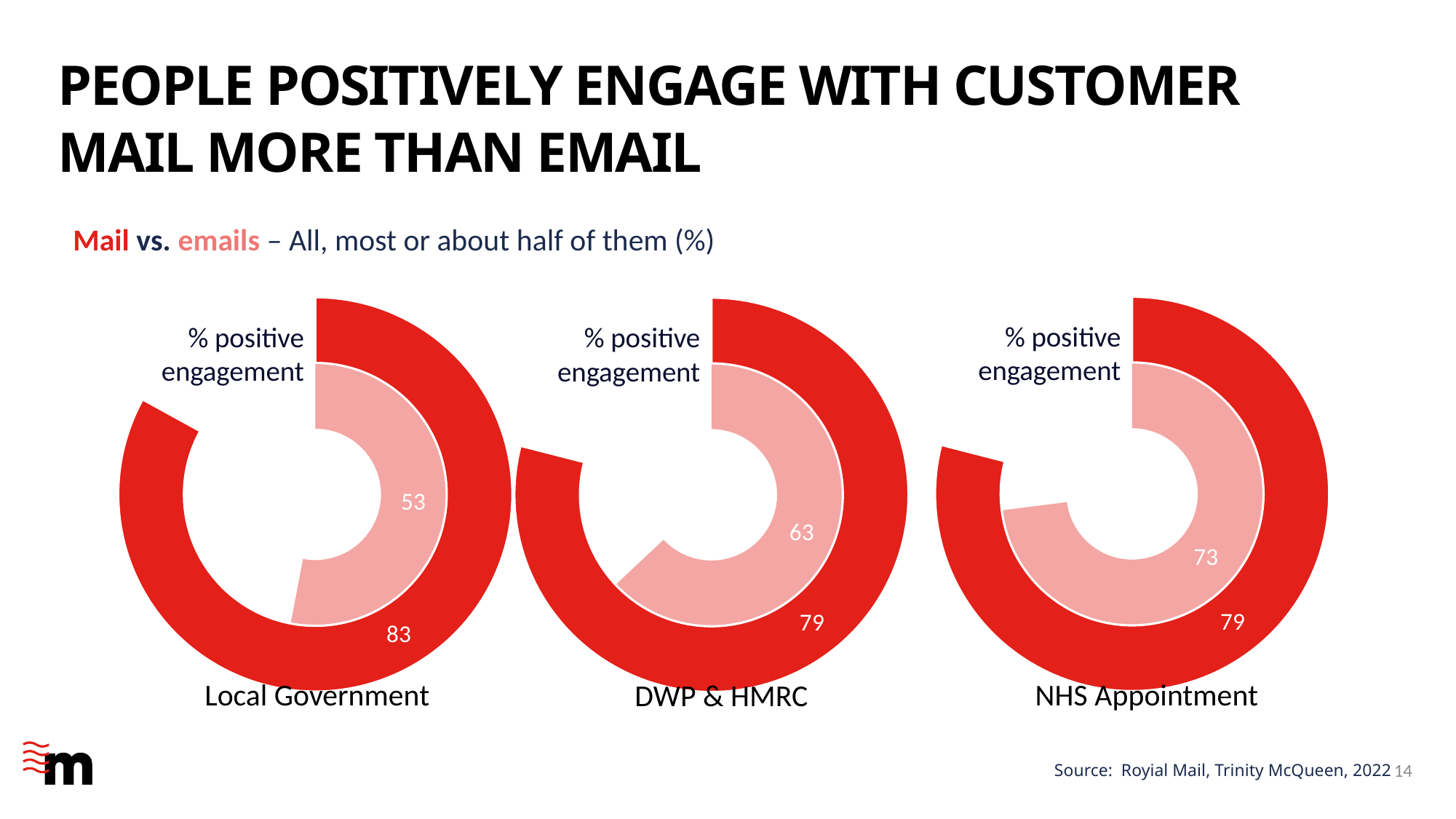
In the DWP & HMRC chart, which has the higher positive engagement, mail or emails? Mail In the NHS Appointment chart, what is the % positive engagement for emails? 73 How many donut charts are shown on the slide? 3 In the DWP & HMRC chart, what is the % positive engagement for emails? 63 Which colour represents emails in the charts? Light pink (inner ring) Across the three charts, which category has the highest mail value? Local Government In the Local Government chart, what is the % positive engagement for mail? 83 Across the three charts, which category has the lowest email value? Local Government In the NHS Appointment chart, what is the difference between the mail and email values? 6 In the Local Government chart, what is the % positive engagement for emails? 53 In the Local Government chart, what is the difference between the mail and email values? 30 In the DWP & HMRC chart, what is the % positive engagement for mail? 79